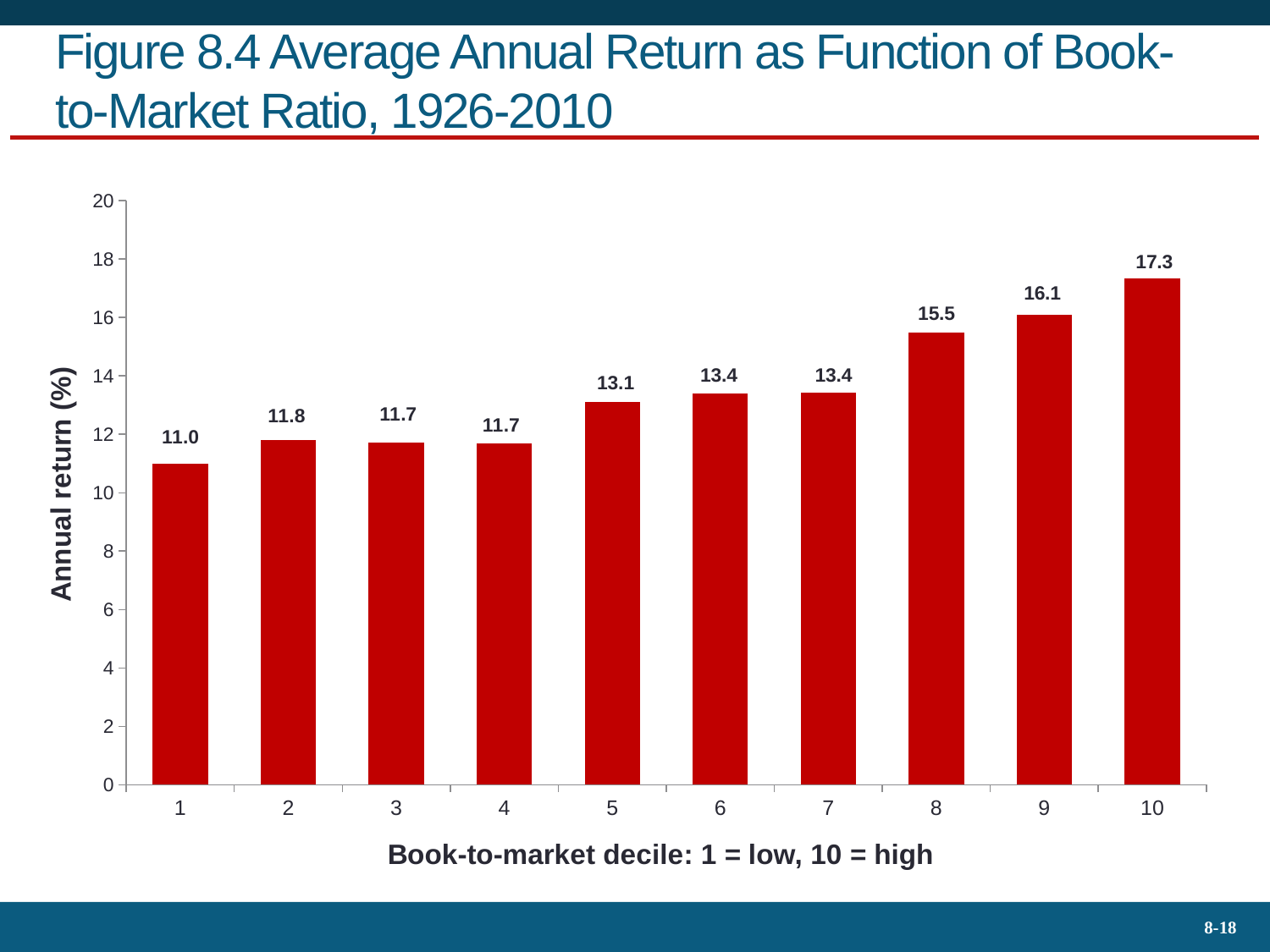
Which book-to-market decile has the highest annual return? 10 What is the difference in annual return between decile 10 and decile 1? 6.3 What is the annual return for book-to-market decile 5? 13.1 What is the annual return for book-to-market decile 1? 11.0 What kind of chart is shown on the slide? Bar chart What is the difference in annual return between decile 9 and decile 8? 0.6 Is the annual return for decile 10 greater or less than 16? greater Which has a higher annual return, decile 2 or decile 9? Decile 9 What is the annual return for book-to-market decile 8? 15.5 Which book-to-market decile has the lowest annual return? 1 How many book-to-market deciles are shown on the chart? 10 Do annual returns generally rise or fall as the book-to-market decile increases from 1 to 10? Rise